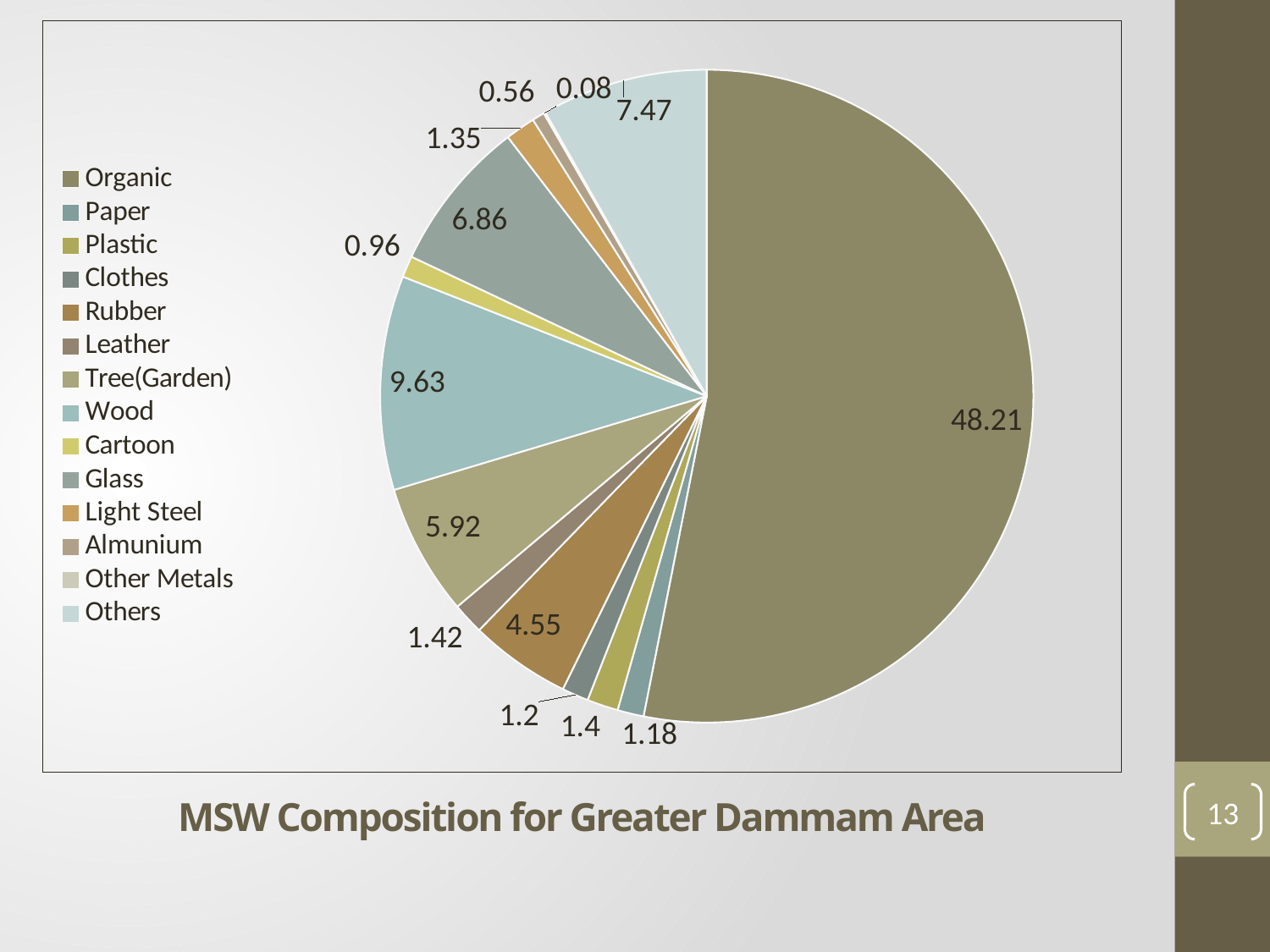
What is the value shown for the Glass slice? 6.86 How many categories does the legend list? 14 What is the difference between the Wood value and the Glass value? 2.77 Which category has the smallest slice of the pie? Other Metals Which category has the largest slice of the pie? Organic What is the title of the chart? MSW Composition for Greater Dammam Area What is the value shown for the Others slice? 7.47 What is the value shown for the Rubber slice? 4.55 What kind of chart is shown on the slide? Pie chart What is the value shown for the Wood slice? 9.63 What is the value shown for the Organic slice? 48.21 Which is larger, the Tree(Garden) slice or the Rubber slice? Tree(Garden)